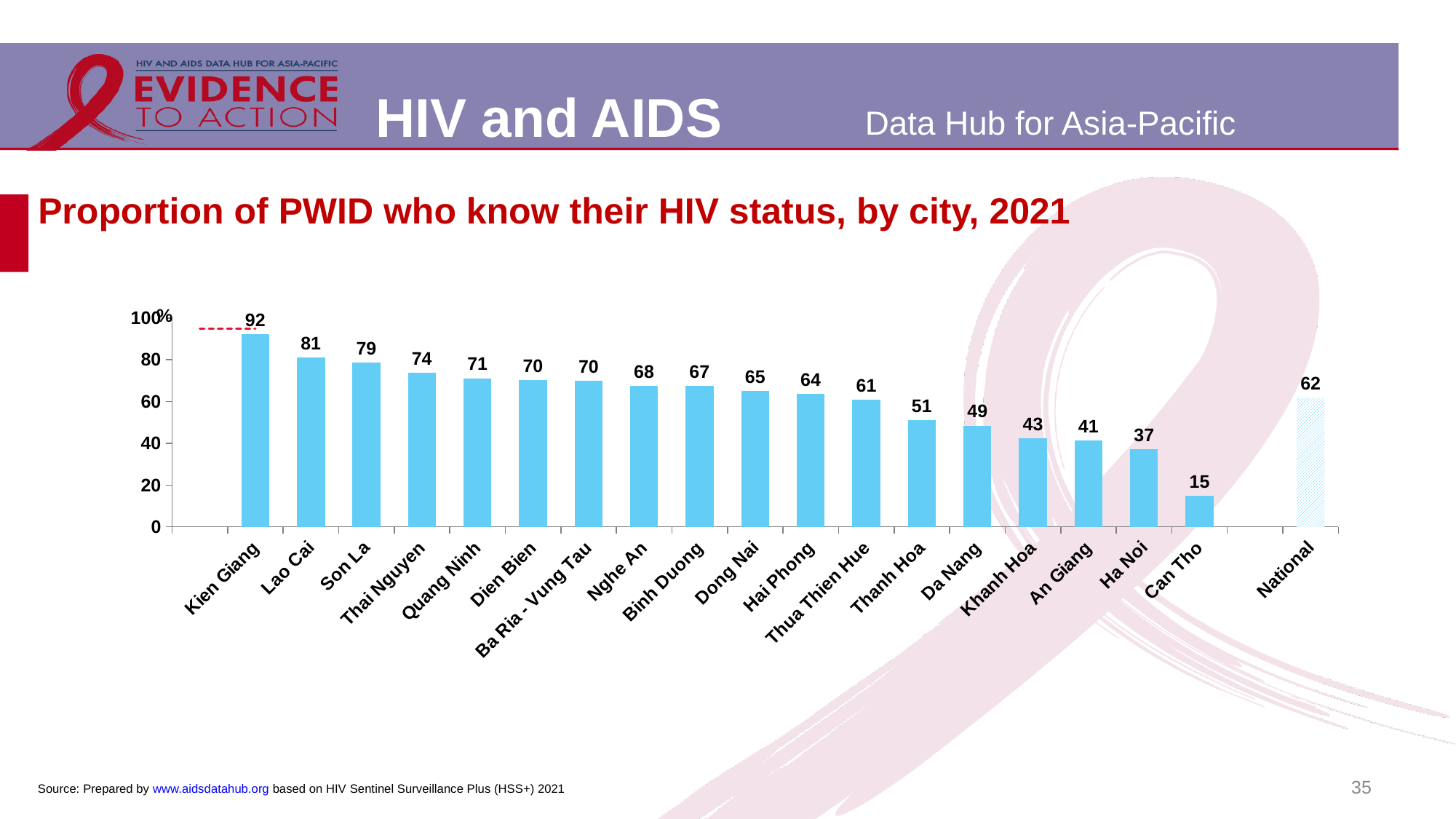
What is the difference between the values for Lao Cai and Can Tho? 66 How many bars are plotted in the chart, including National? 19 What kind of chart is shown on the slide? Bar chart Which city has the lowest proportion of PWID who know their HIV status? Can Tho What is the value for Kien Giang? 92 Is the value for Khanh Hoa greater or less than 60? less Which city has the highest proportion of PWID who know their HIV status? Kien Giang What is the value for Ha Noi? 37 What is the difference between the value for Kien Giang and the National value? 30 Do the city values rise or fall from left to right along the x axis? Fall Which has a larger value, Da Nang or Thanh Hoa? Thanh Hoa What is the National value shown in the chart? 62